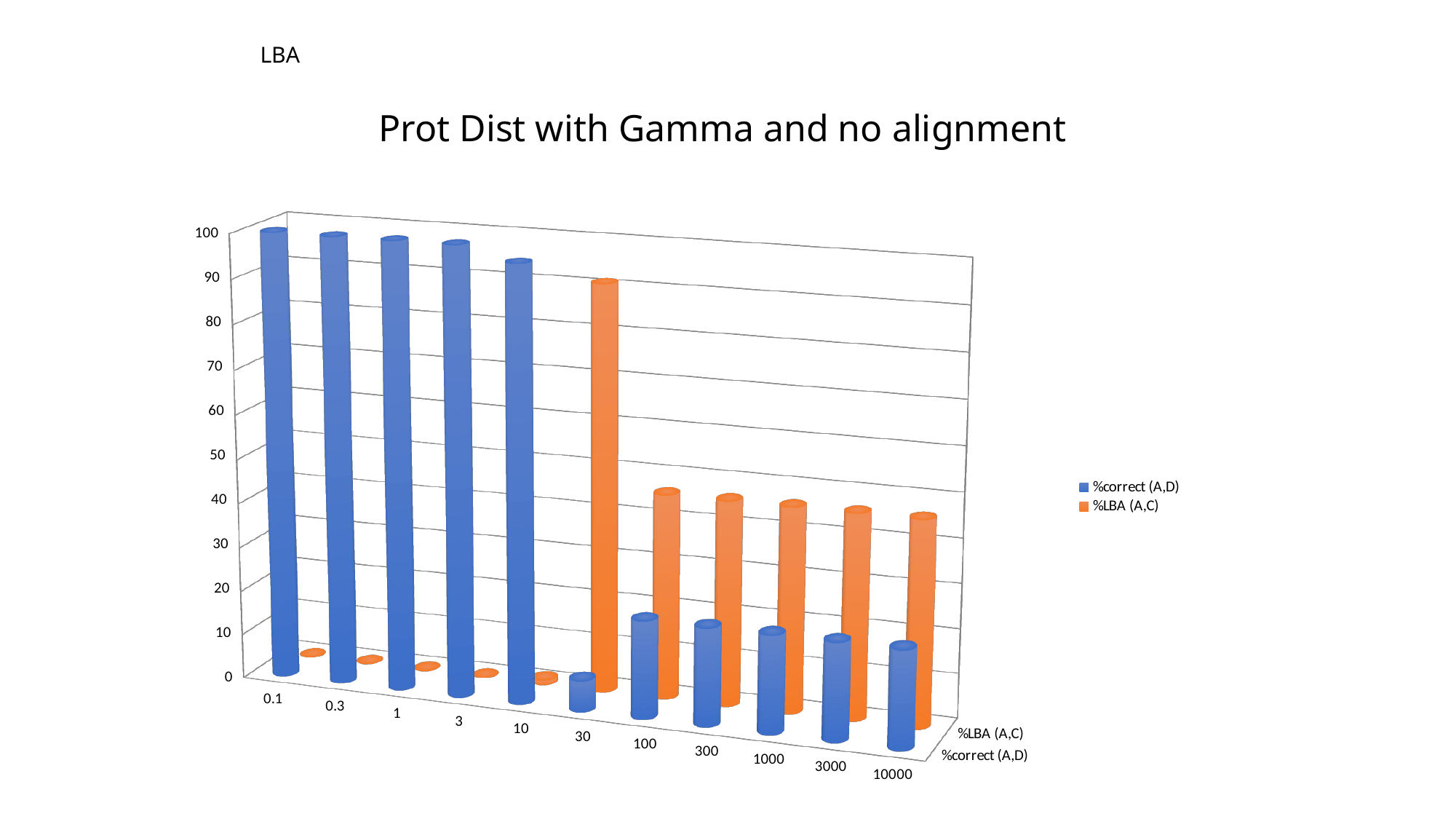
What kind of chart is shown on the slide? bar chart At category 0.1, which series has the larger value, %correct (A,D) or %LBA (A,C)? %correct (A,D) Is the %correct (A,D) value for 0.1 greater or less than 90? greater How many series does the legend list? 2 Do the %correct (A,D) values rise or fall as you move along the x axis from 0.1 to 10000? fall Which category has the highest value for %LBA (A,C)? 30 Is the %LBA (A,C) value for 30 greater or less than 80? greater How many categories are shown along the x axis? 11 Which colour represents the %LBA (A,C) series? orange Is the %LBA (A,C) value for 100 greater or less than 50? less At category 30, which series has the larger value, %correct (A,D) or %LBA (A,C)? %LBA (A,C) What is the title of the chart? Prot Dist with Gamma and no alignment